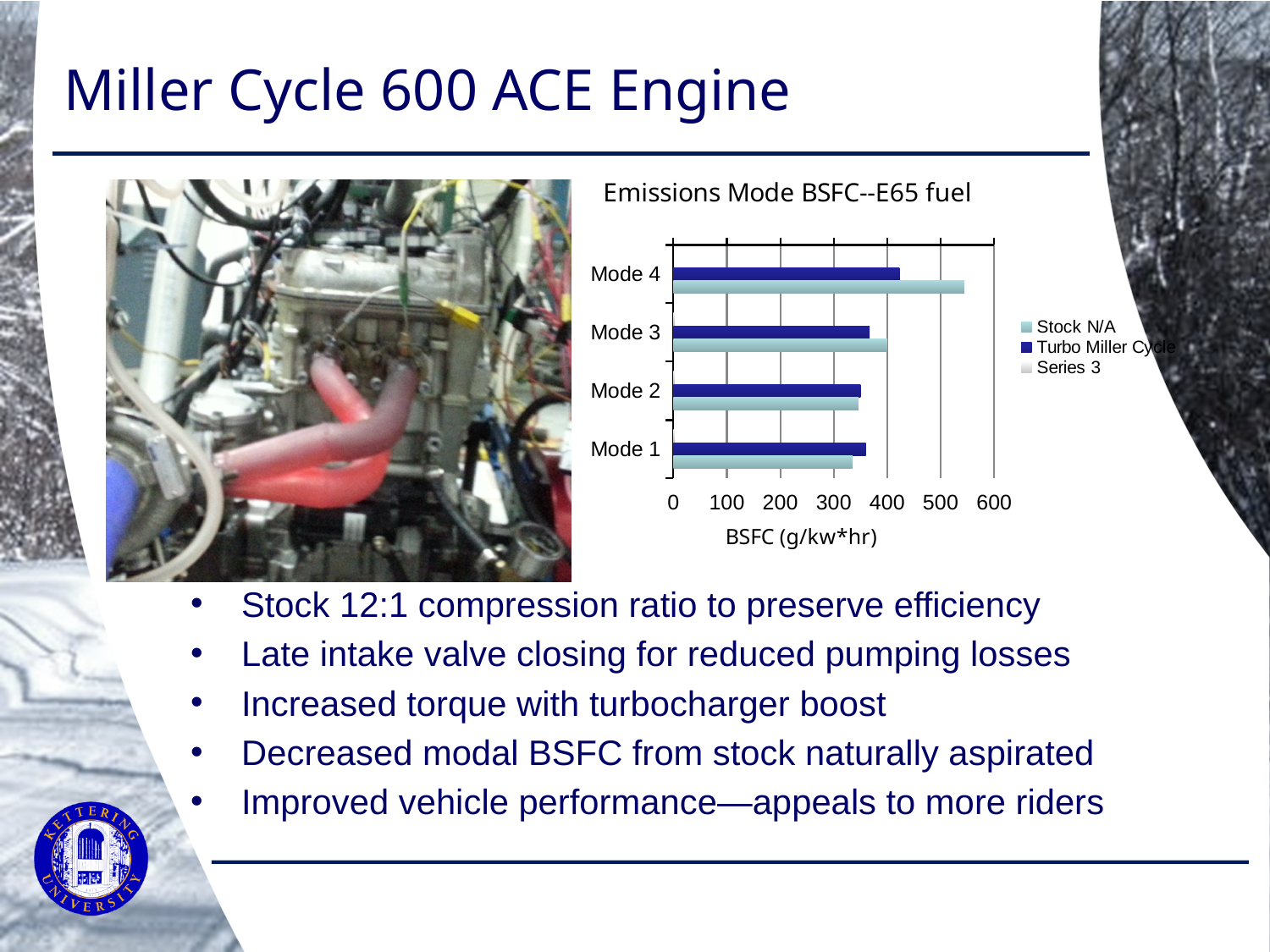
For Mode 4, which is larger: the Stock N/A value or the Turbo Miller Cycle value? Stock N/A How many emission modes are shown on the chart? 4 For Mode 3, which is larger: the Stock N/A value or the Turbo Miller Cycle value? Stock N/A Which mode has the highest Stock N/A BSFC value? Mode 4 What is the title of the chart? Emissions Mode BSFC--E65 fuel How many series does the chart legend list? 3 Is the Turbo Miller Cycle value for Mode 3 greater or less than 400? less Is the Turbo Miller Cycle value for Mode 4 greater or less than 400? greater What kind of chart is shown on the slide? bar chart Is the Stock N/A value for Mode 4 greater or less than 500? greater What is the label of the horizontal axis of the chart? BSFC (g/kw*hr) Which mode has the highest Turbo Miller Cycle BSFC value? Mode 4